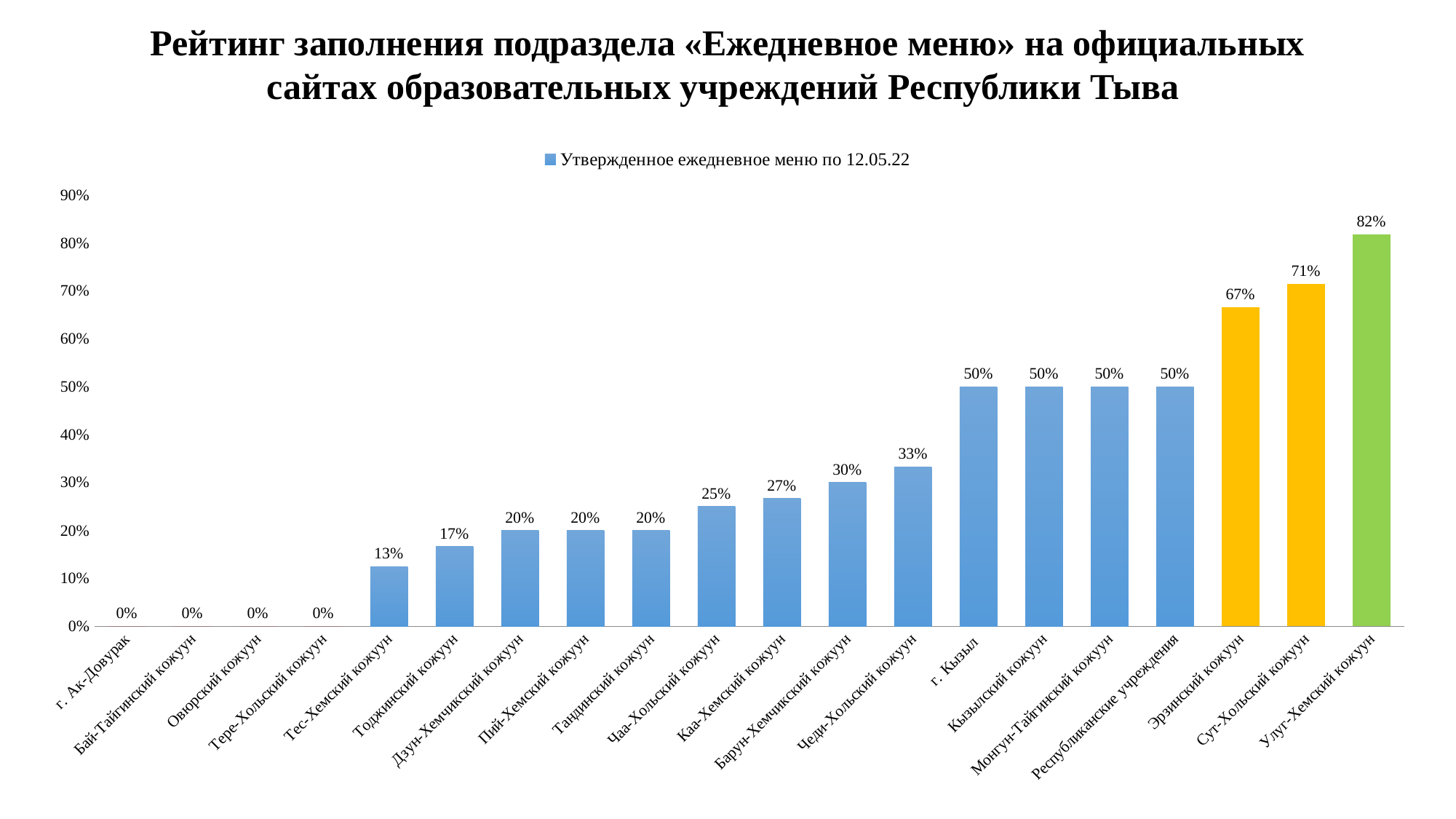
What is the legend entry for the series? Утвержденное ежедневное меню по 12.05.22 What is the value for Эрзинский кожуун? 67% What is the value for Улуг-Хемский кожуун? 82% What is the value for Тес-Хемский кожуун? 13% How many categories are shown on the x axis? 20 Which is larger, the value for Каа-Хемский кожуун or the value for Барун-Хемчикский кожуун? Барун-Хемчикский кожуун What is the difference between the values for Сут-Хольский кожуун and Эрзинский кожуун? 4% Which category has the highest value? Улуг-Хемский кожуун How many series does the legend list? 1 What is the value for Чеди-Хольский кожуун? 33% What type of chart is shown on the slide? bar chart Do the values generally rise or fall from left to right along the x axis? rise